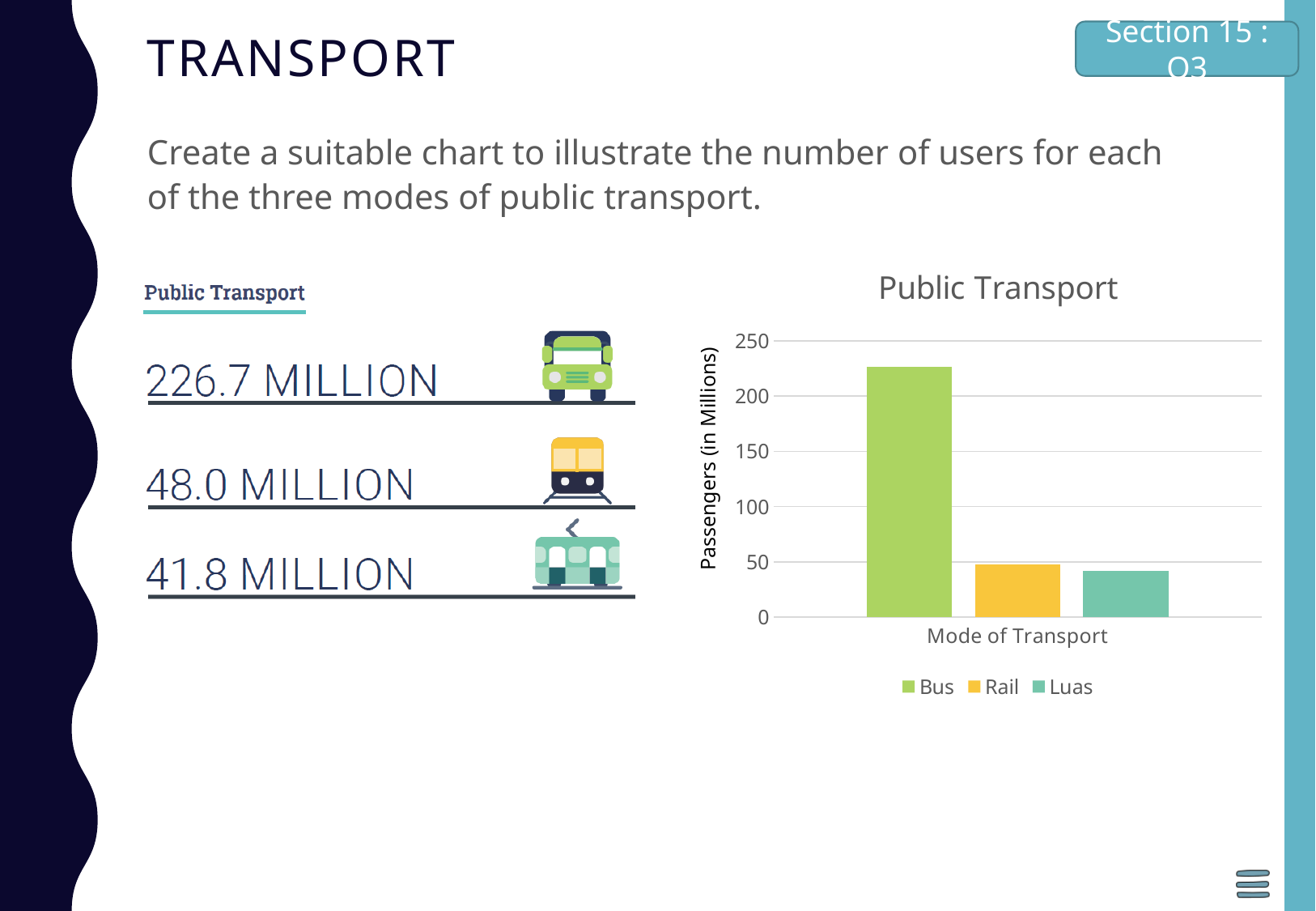
Is the value for Bus greater or less than 200? greater Which mode of transport has the highest value in the Public Transport chart? Bus Is the value for Bus greater or less than 250? less What is the label on the vertical axis of the chart? Passengers (in Millions) How many bars are plotted in the Public Transport chart? 3 Which is larger in the Public Transport chart, the value for Bus or the value for Rail? Bus Which is larger in the Public Transport chart, the value for Bus or the value for Luas? Bus What is the title of the chart? Public Transport What kind of chart is shown on the slide? bar chart How many series does the legend of the Public Transport chart list? 3 Is the value for Luas greater or less than 50? less